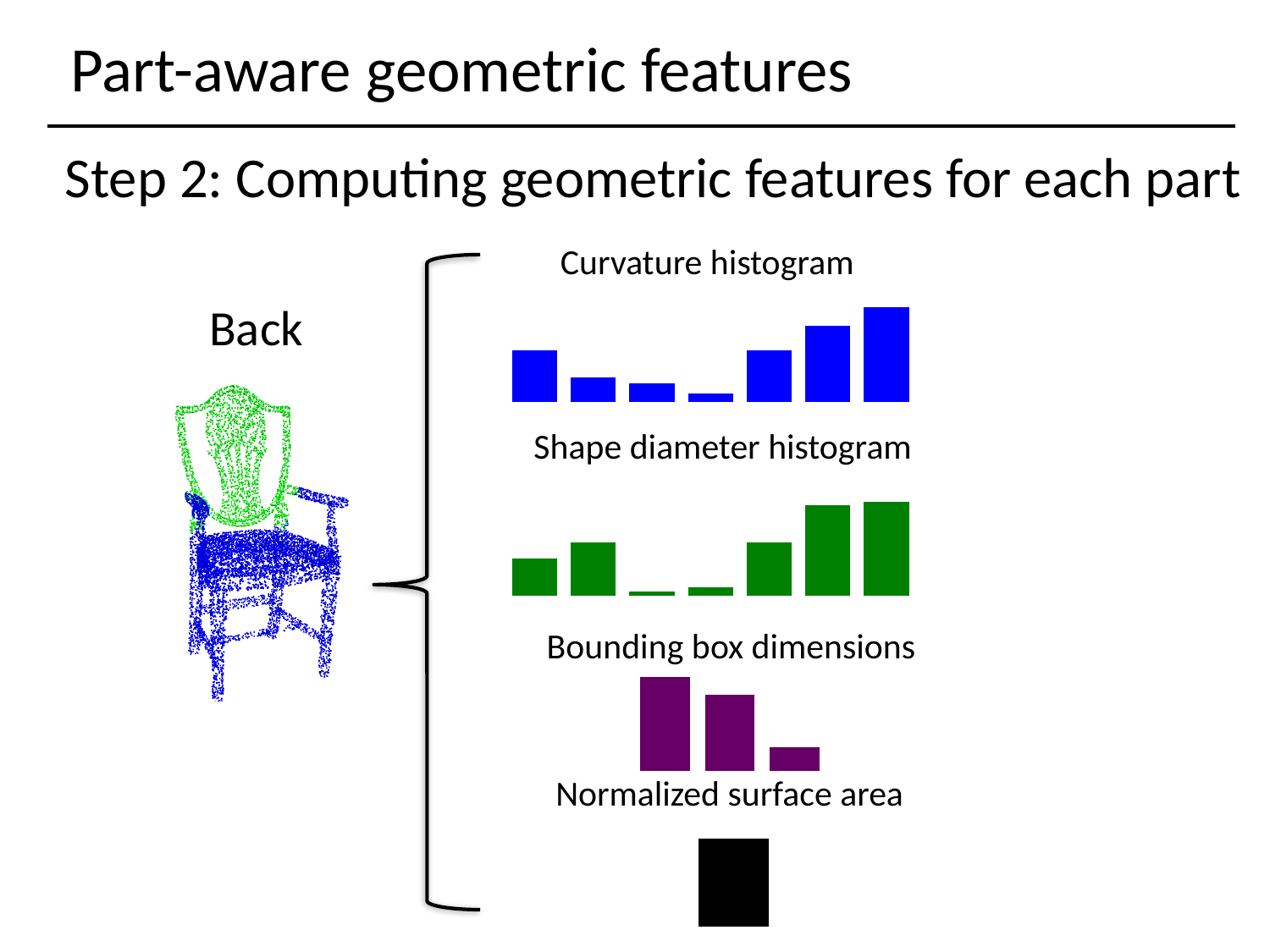
In the Curvature histogram, which is taller, the first bar or the second bar? the first bar In the Curvature histogram, which bar is the tallest? the rightmost (seventh) bar How many bars does the Bounding box dimensions chart show? 3 What colour are the bars in the Bounding box dimensions chart? purple What kind of chart is the Curvature histogram? bar chart In the Bounding box dimensions chart, do the bars rise or fall from left to right? fall How many bars does the Shape diameter histogram chart show? 7 In the Curvature histogram, which bar is the shortest? the fourth bar How many bars does the Curvature histogram chart show? 7 In the Bounding box dimensions chart, which bar is the tallest? the first (leftmost) bar What colour are the bars in the Shape diameter histogram? green In the Shape diameter histogram, which bar is the shortest? the third bar